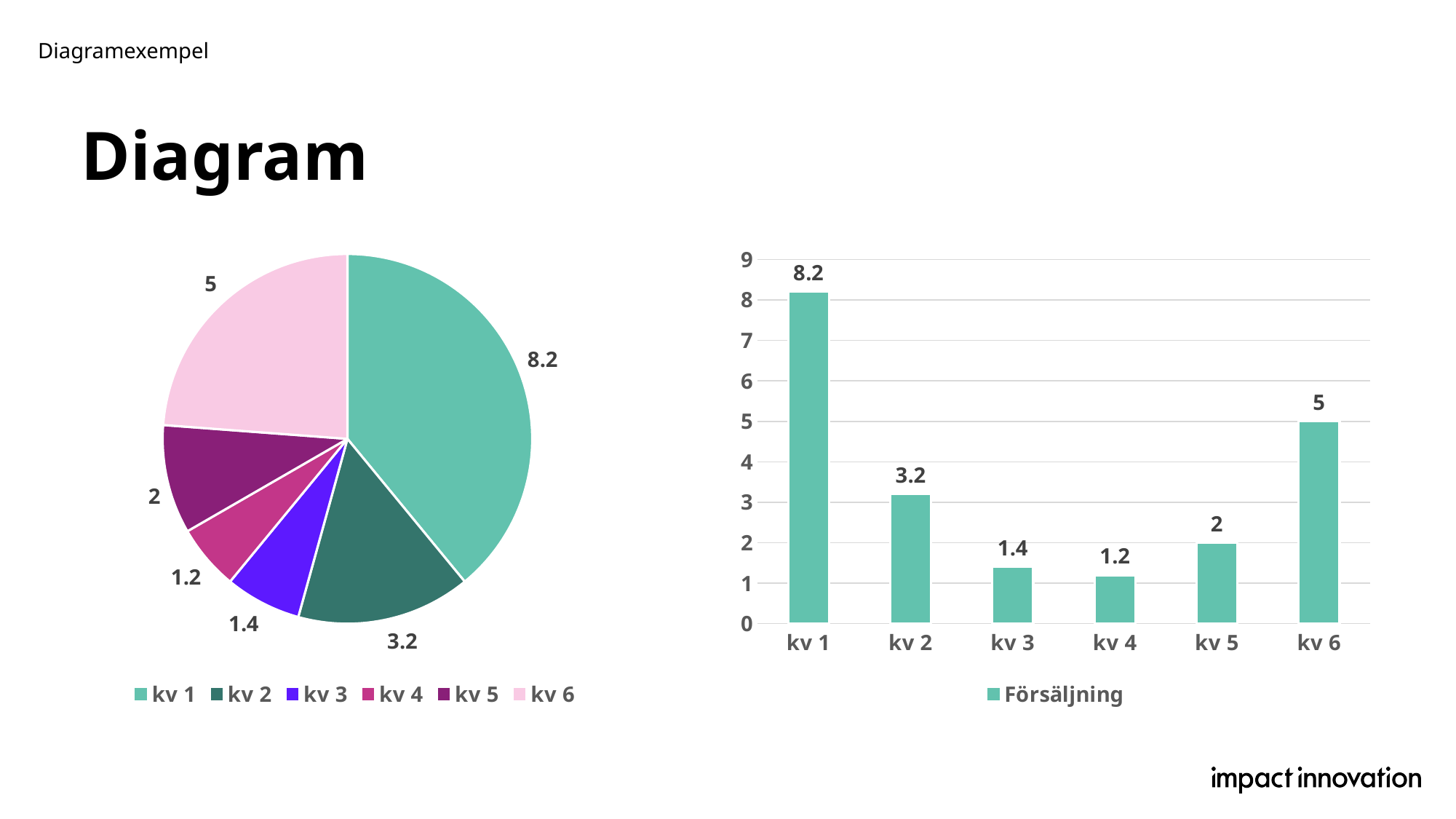
In the pie chart on the left, which slice is the largest? kv 1 In the bar chart on the right, what is the difference between the values for kv 1 and kv 6? 3.2 In the bar chart on the right, do the values rise or fall from kv 1 to kv 4? Fall In the pie chart on the left, what value is shown for the kv 6 slice? 5 What kind of chart is on the left side of the slide? Pie chart In the bar chart on the right, which is larger, the value for kv 2 or the value for kv 5? kv 2 In the bar chart on the right, what is the value for kv 1? 8.2 In the bar chart on the right, is the value for kv 6 greater or less than 4? greater How many series does the legend of the bar chart on the right list? 1 In the bar chart on the right, which category has the lowest value? kv 4 How many categories are shown in the bar chart on the right? 6 What is the name of the series in the legend of the bar chart on the right? Försäljning